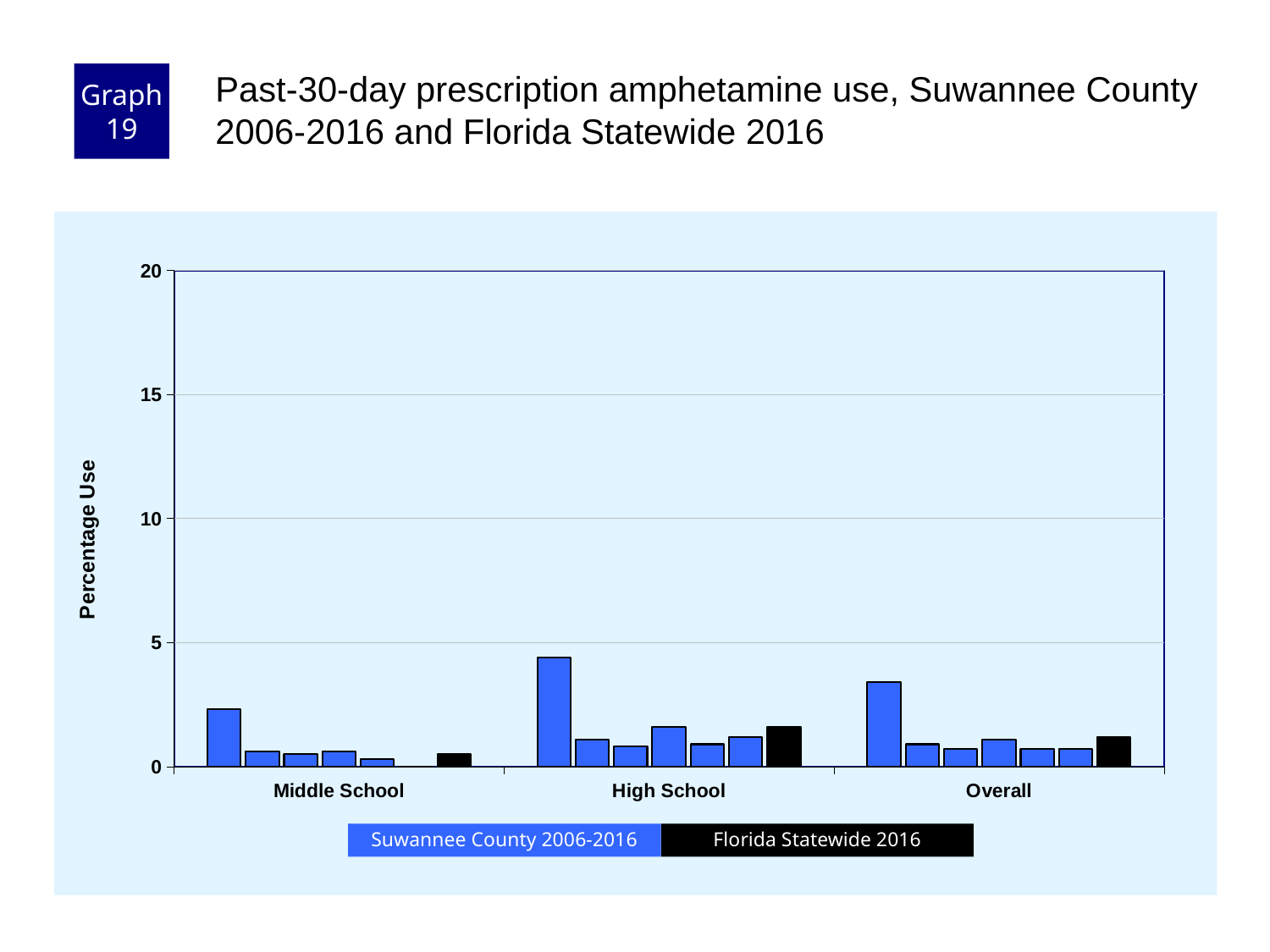
Is the Florida Statewide 2016 bar larger for High School or for Middle School? High School Which category contains the tallest bar in the chart? High School How many categories are shown on the x axis? 3 Which category has the lowest Florida Statewide 2016 bar? Middle School Which colour represents Florida Statewide 2016 in the legend? black Is the Florida Statewide 2016 bar larger for Overall or for Middle School? Overall Is the tallest bar for High School greater or less than 5? less Is the tallest bar for Overall greater or less than 5? less Is the Florida Statewide 2016 value for High School greater or less than 5? less What is the label on the y axis? Percentage Use What kind of chart is shown on the slide? bar chart How many series does the legend list? 2